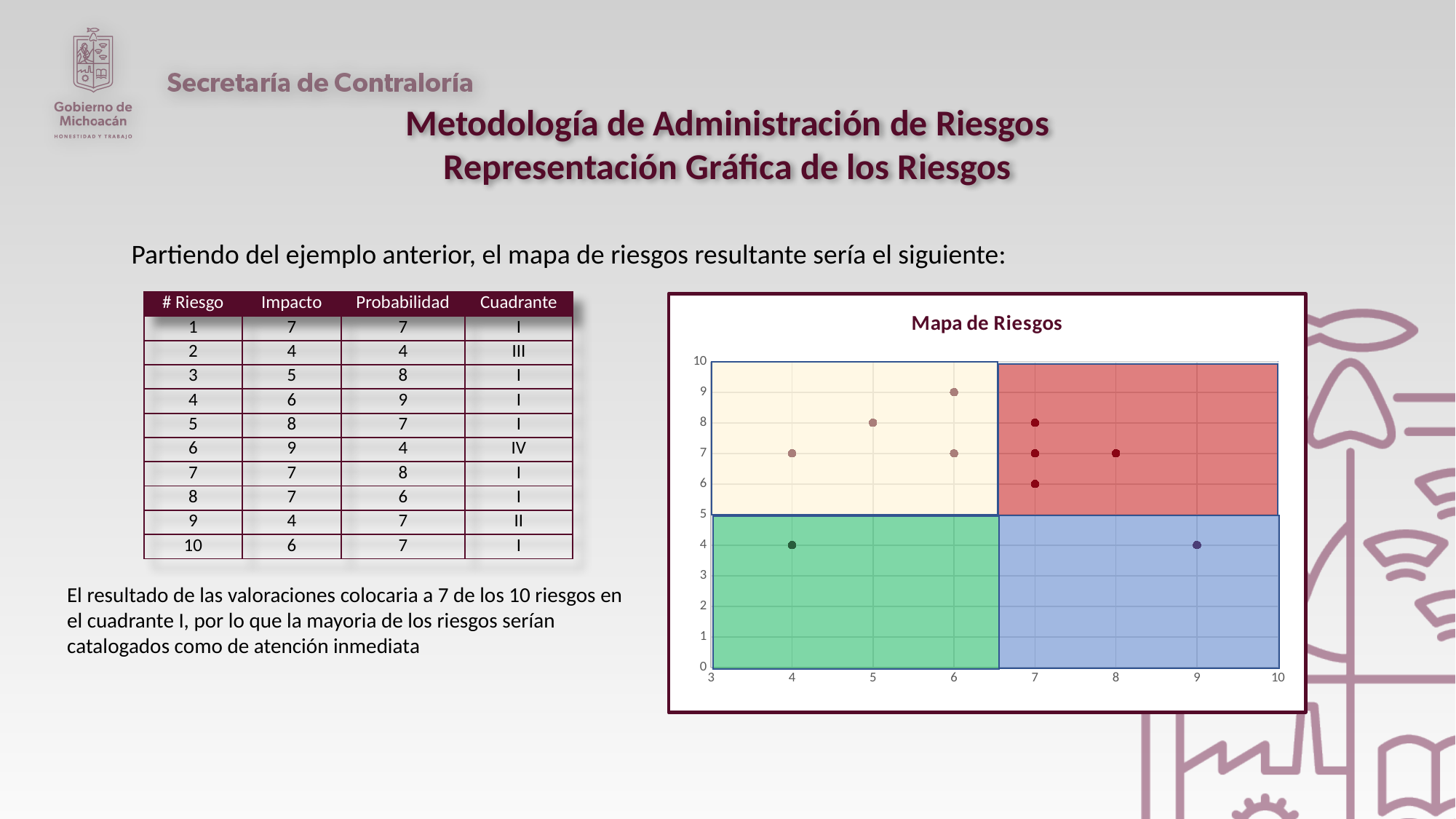
On the "Mapa de Riesgos" chart, what is the y-axis value of the point plotted at x = 8? 7 What kind of chart is the "Mapa de Riesgos" chart? scatter chart On the "Mapa de Riesgos" chart, what is the y-axis value of the point plotted at x = 5? 8 On the "Mapa de Riesgos" chart, what is the y-axis value of the point plotted at x = 9? 4 On the "Mapa de Riesgos" chart, what is the highest y-axis value reached by any point? 9 On the "Mapa de Riesgos" chart, how many points fall in the red (upper-right) quadrant? 4 What is the title of the chart on the right of the slide? Mapa de Riesgos How many data points are plotted on the "Mapa de Riesgos" chart? 10 On the "Mapa de Riesgos" chart, is the y value of the point at x = 9 greater or less than 5? less On the "Mapa de Riesgos" chart, how many points are plotted at x = 7? 3 On the "Mapa de Riesgos" chart, what is the largest x-axis value at which a point is plotted? 9